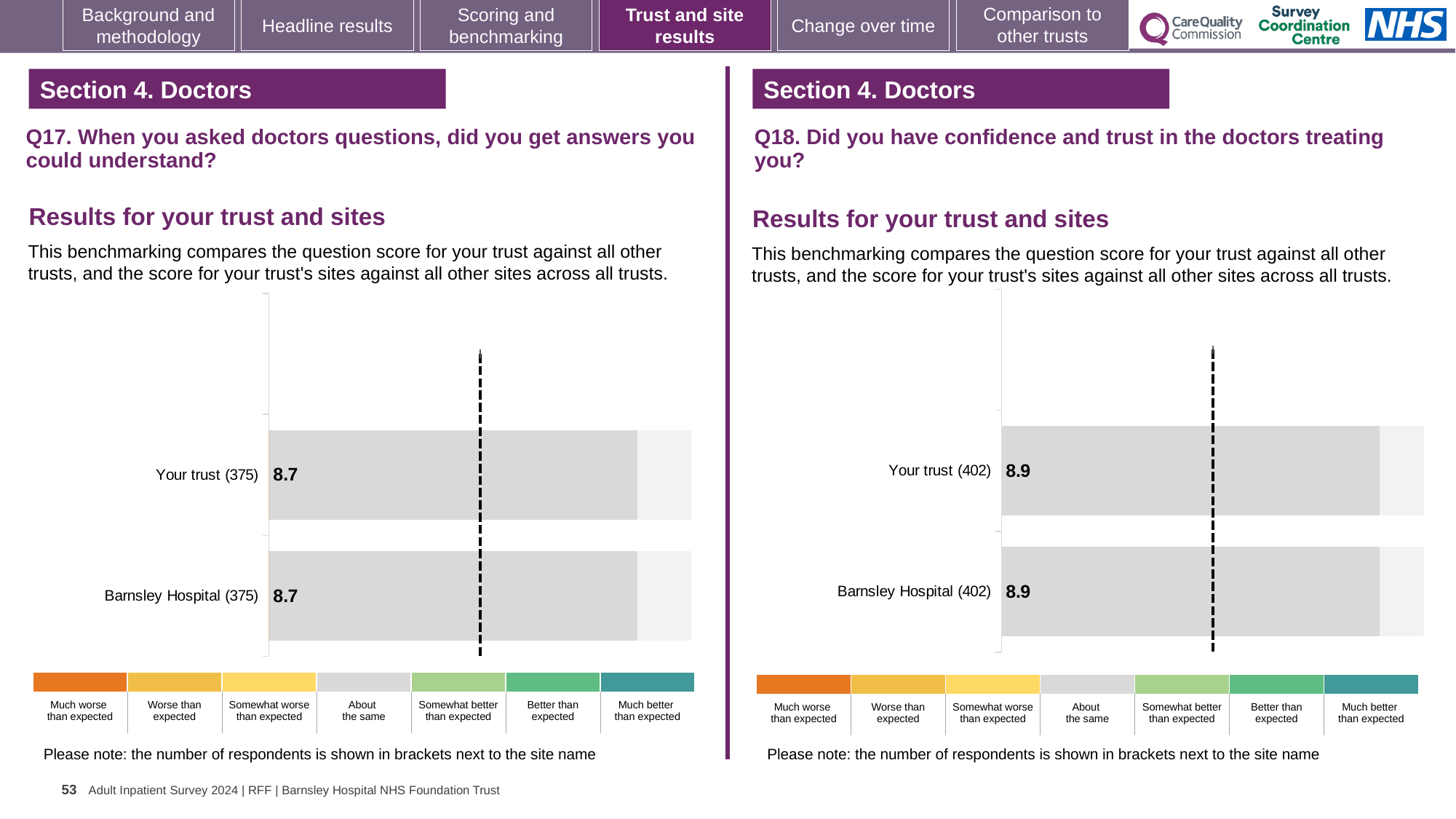
In the Q18 chart on the right, how many respondents are shown in brackets for Barnsley Hospital? 402 In the Q17 chart on the left, how many respondents are shown in brackets for Your trust? 375 What type of chart is used for the Q17 results on the left? Bar chart In the Q17 chart on the left, what is the score for Your trust (375)? 8.7 In the Q17 chart on the left, what is the difference between the scores for Your trust and Barnsley Hospital? 0.0 How many bars are plotted in the Q17 chart on the left? 2 In the Q18 chart on the right, what is the score for Your trust (402)? 8.9 In the Q18 chart on the right, which benchmark category does the grey colour of the bars correspond to in the legend? About the same How many bars are plotted in the Q18 chart on the right? 2 In the Q18 chart on the right, what is the difference between the scores for Your trust and Barnsley Hospital? 0.0 In the Q17 chart on the left, what is the score for Barnsley Hospital (375)? 8.7 In the Q18 chart on the right, what is the score for Barnsley Hospital (402)? 8.9